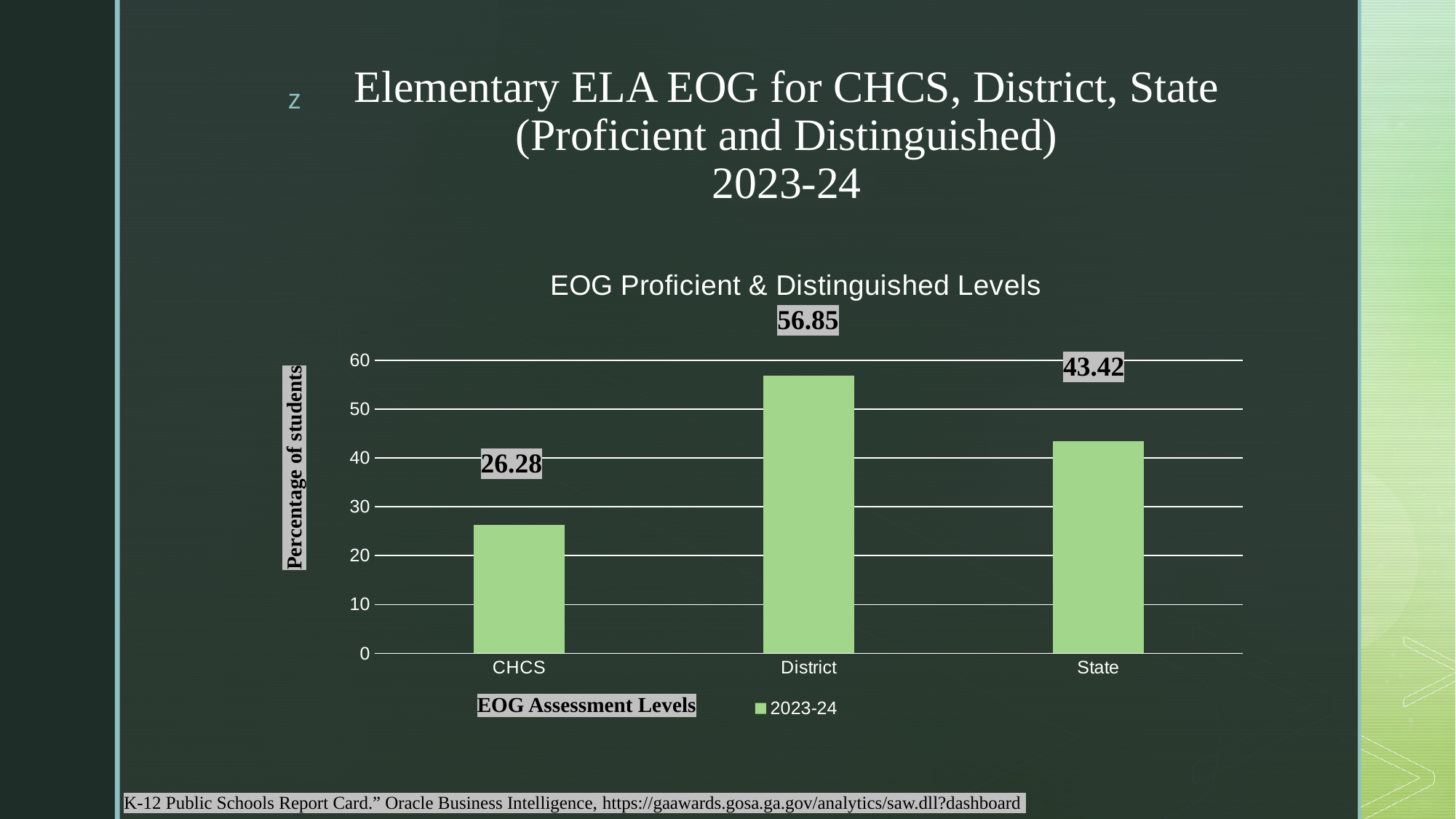
Which is larger, the value for State or the value for CHCS? State Which category has the highest value? District Is the value for State greater or less than 40? greater What kind of chart is shown? bar chart How many categories are shown on the x axis? 3 What is the value for CHCS? 26.28 What is the difference between the District value and the CHCS value? 30.57 What is the difference between the State value and the CHCS value? 17.14 What series does the legend list? 2023-24 What is the value for State? 43.42 What is the value for District? 56.85 Which category has the lowest value? CHCS